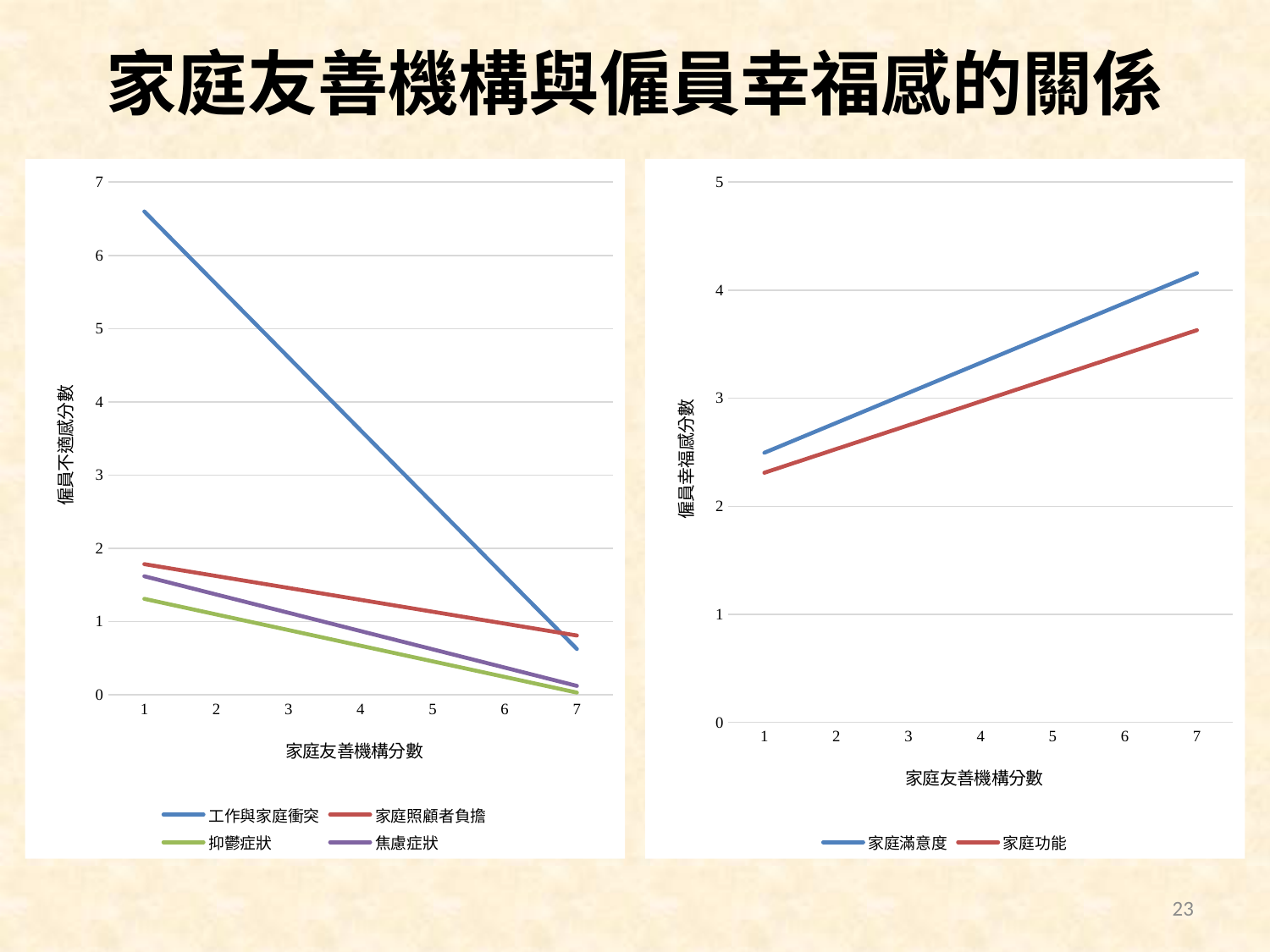
In the right chart (僱員幸福感分數), do the values for 家庭滿意度 rise or fall as 家庭友善機構分數 increases from 1 to 7? rise How many series does the legend of the left chart (僱員不適感分數) list? 4 In the left chart (僱員不適感分數), is the value for 工作與家庭衝突 at 家庭友善機構分數 1 greater or less than 6? greater In the left chart (僱員不適感分數), which series has the highest value at 家庭友善機構分數 1? 工作與家庭衝突 How many series does the legend of the right chart (僱員幸福感分數) list? 2 In the right chart (僱員幸福感分數), is the value for 家庭滿意度 at 家庭友善機構分數 1 greater or less than 2? greater What is the x-axis title of the right chart (僱員幸福感分數)? 家庭友善機構分數 In the right chart (僱員幸福感分數), is the value for 家庭功能 at 家庭友善機構分數 7 greater or less than 4? less What kind of chart is the left chart (僱員不適感分數)? line chart In the left chart (僱員不適感分數), do the values for 工作與家庭衝突 rise or fall as 家庭友善機構分數 increases from 1 to 7? fall In the right chart (僱員幸福感分數), which is larger at 家庭友善機構分數 7: 家庭滿意度 or 家庭功能? 家庭滿意度